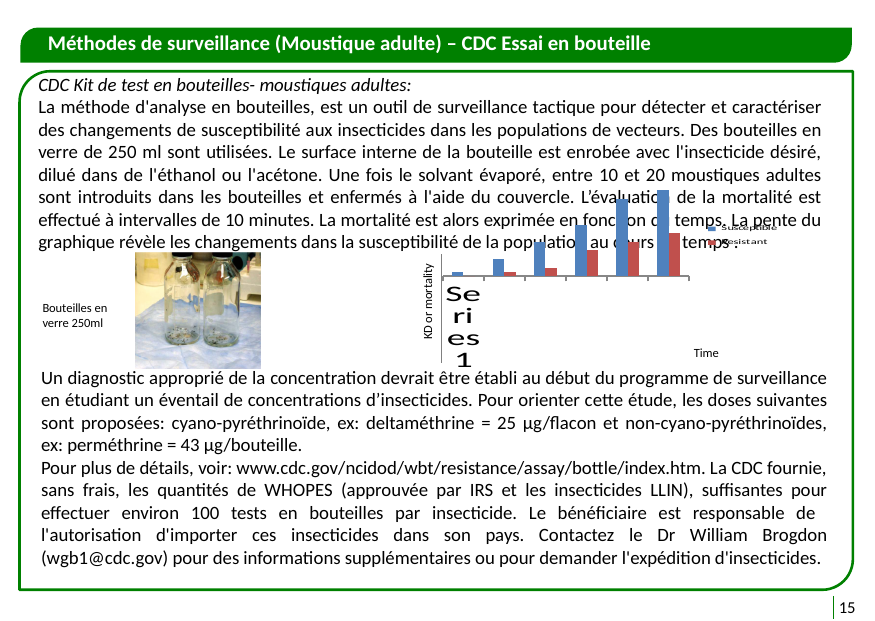
What kind of chart is shown on the slide? bar chart What is the label on the vertical axis of the chart? KD or mortality Do the Susceptible bars rise or fall from left to right along the Time axis? rise At the rightmost time point, which series has the taller bar, Susceptible or Resistant? Susceptible Which series generally shows higher KD or mortality across the time points, Susceptible or Resistant? Susceptible What are the two series named in the chart's legend? Susceptible and Resistant How many series does the chart's legend list? 2 Do the Resistant bars rise or fall from left to right along the Time axis? rise